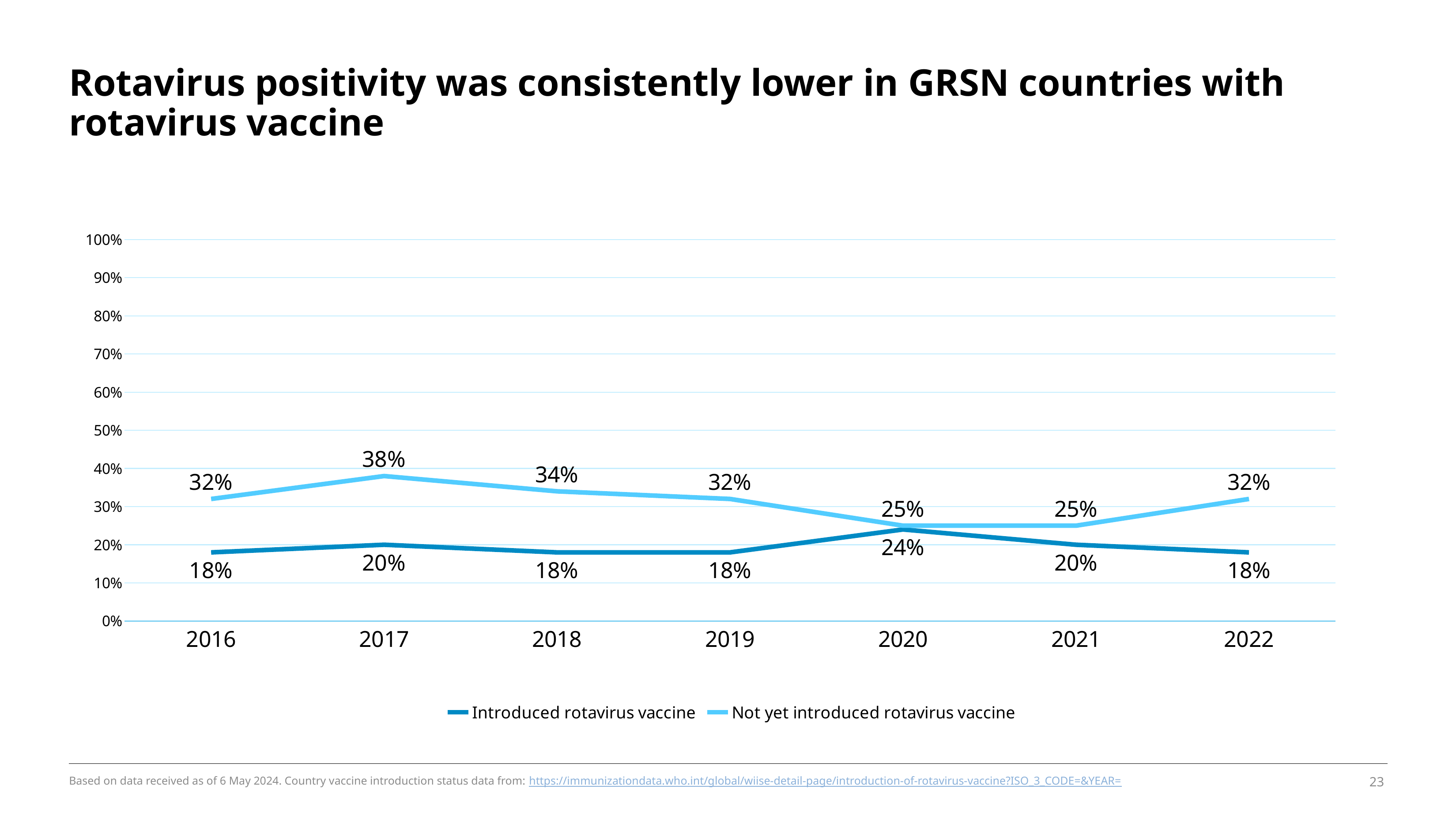
What was the rotavirus positivity for countries that had introduced rotavirus vaccine in 2020? 24% In which year was rotavirus positivity highest for countries that had not yet introduced rotavirus vaccine? 2017 How many series does the legend list? 2 What kind of chart is shown on the slide? Line chart What was the rotavirus positivity for countries that had not yet introduced rotavirus vaccine in 2022? 32% In which year was rotavirus positivity highest for countries that had introduced rotavirus vaccine? 2020 What is the difference in rotavirus positivity between the two groups in 2017? 18% How many years are shown on the x axis? 7 What was the rotavirus positivity for countries that had not yet introduced rotavirus vaccine in 2017? 38% Did rotavirus positivity for countries that had not yet introduced rotavirus vaccine rise or fall from 2017 to 2020? Fall Which group had higher rotavirus positivity in 2018: countries that had introduced rotavirus vaccine or countries that had not yet introduced it? Not yet introduced rotavirus vaccine What is the difference in rotavirus positivity between the two groups in 2020? 1%